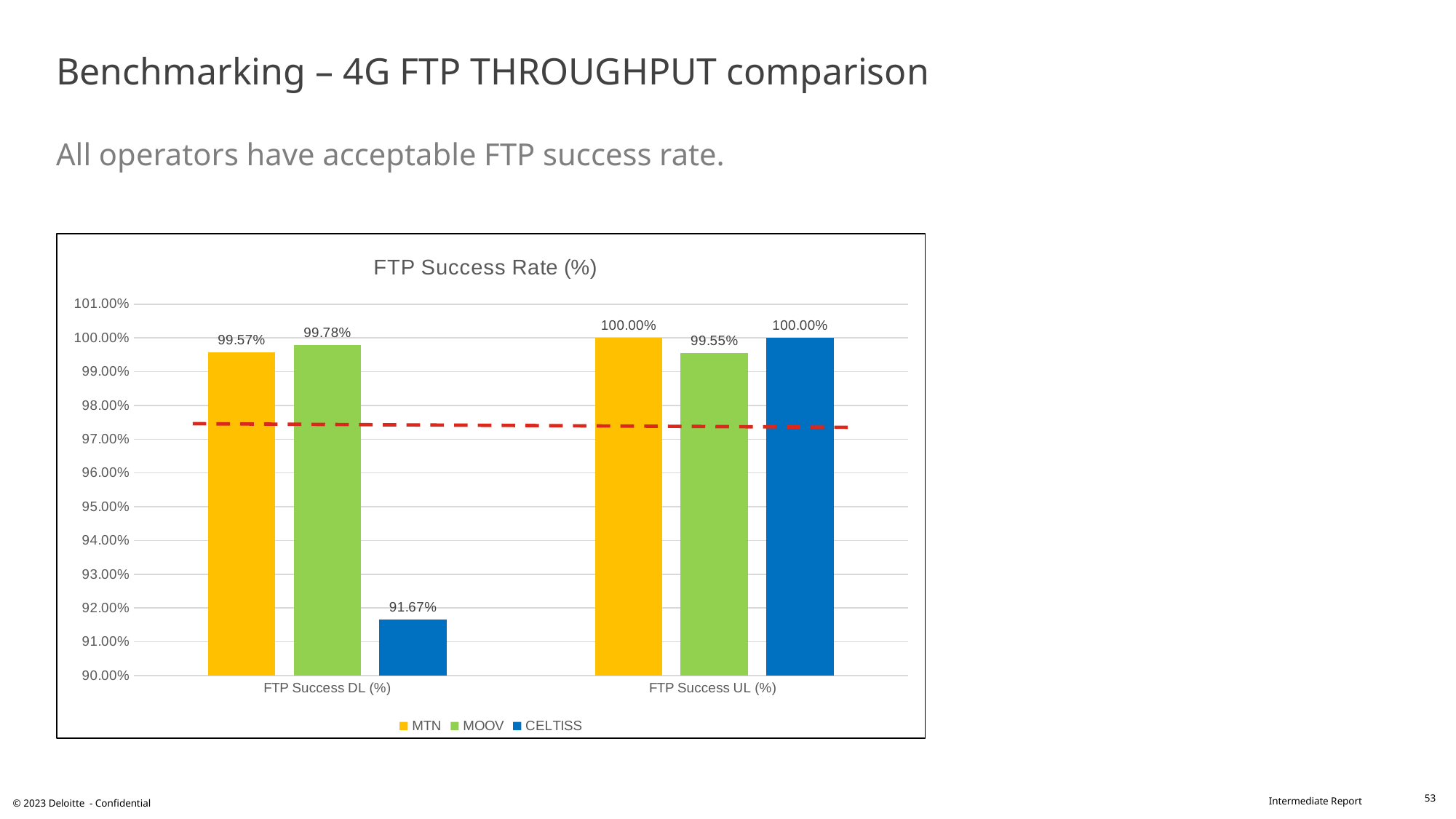
Which operator has the highest FTP Success DL (%)? MOOV How many series does the legend list? 3 Which operator has the lowest FTP Success DL (%)? CELTISS What is the difference between MOOV's and CELTISS's FTP Success DL (%) values? 8.11% What is the FTP Success DL (%) value for MTN? 99.57% What is the title of the chart? FTP Success Rate (%) Which operator has the lowest FTP Success UL (%)? MOOV What is the difference between MTN's and MOOV's FTP Success UL (%) values? 0.45% What kind of chart is shown on the slide? Bar chart What is the FTP Success DL (%) value for CELTISS? 91.67% Which is larger: CELTISS's FTP Success DL (%) or CELTISS's FTP Success UL (%)? FTP Success UL (%) What is the FTP Success UL (%) value for MOOV? 99.55%